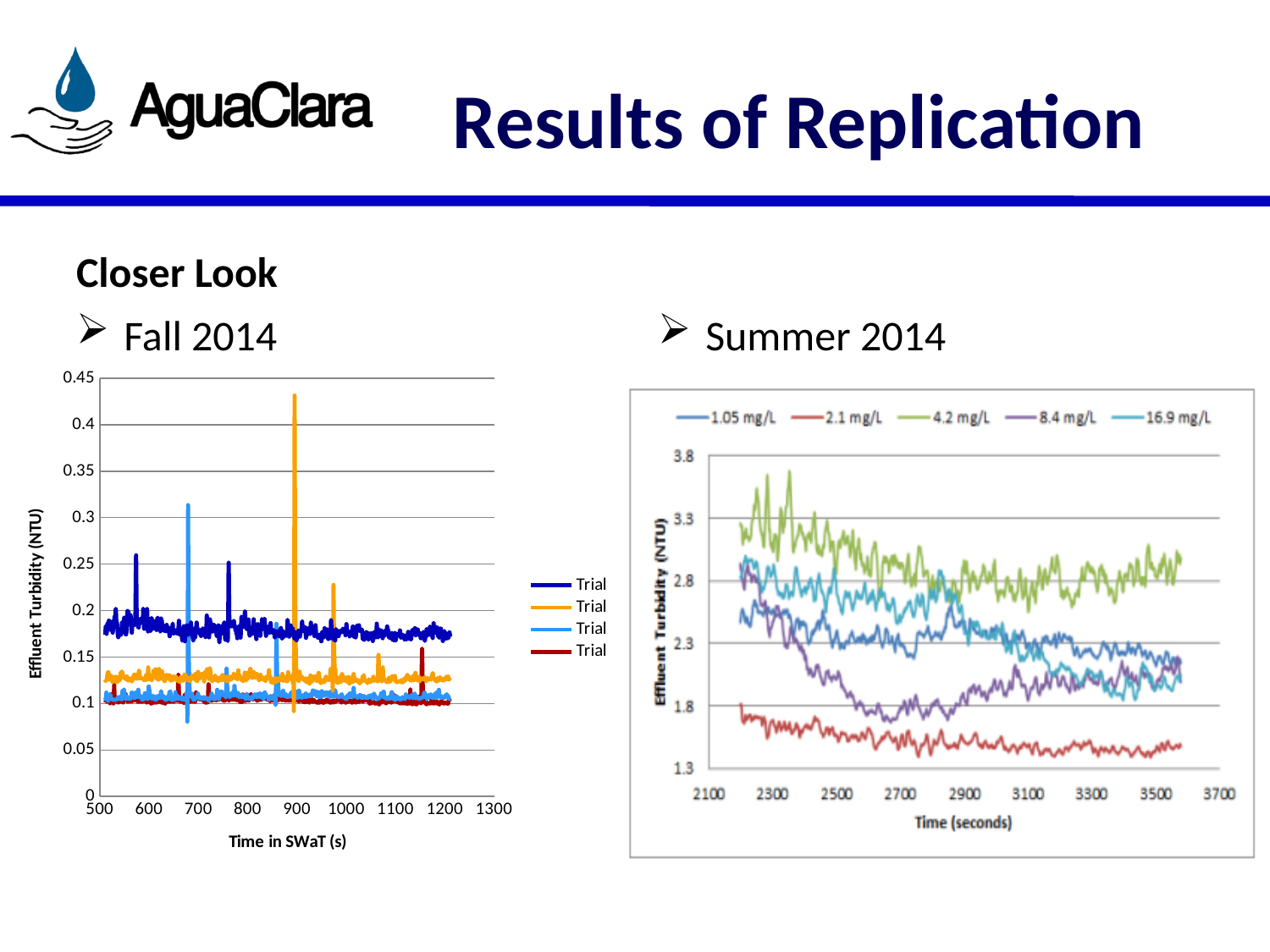
What type of chart is the Fall 2014 chart on the left? line chart In the Summer 2014 chart, does the 1.05 mg/L series rise or fall over time? fall How many series does the legend of the Fall 2014 chart list? 4 In the Fall 2014 chart, is the highest spike of the orange series greater or less than 0.4 NTU? greater In the Fall 2014 chart, is the dark blue series mostly greater or less than 0.15 NTU? greater In the Fall 2014 chart, is the dark red series mostly greater or less than 0.15 NTU? less In the Summer 2014 chart, which series has the highest effluent turbidity overall? 4.2 mg/L In the Summer 2014 chart, what is the label on the x-axis? Time (seconds) In the Summer 2014 chart, which series has the lowest effluent turbidity overall? 2.1 mg/L How many series does the legend of the Summer 2014 chart list? 5 In the Fall 2014 chart, what is the label on the y-axis? Effluent Turbidity (NTU)